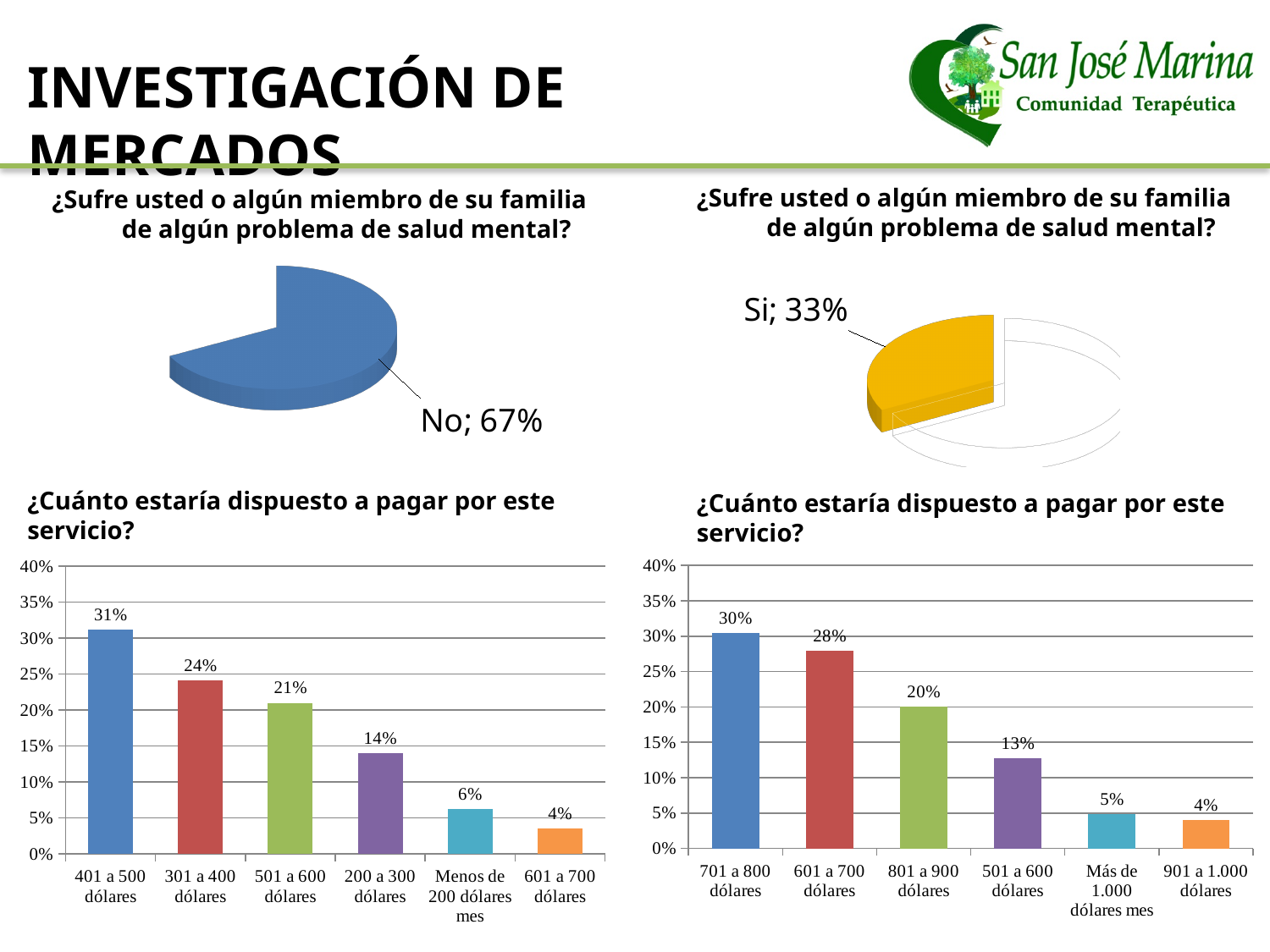
In the top-left pie chart, what share is labelled for No? 67% In the bottom-right bar chart, do the values rise or fall from left to right along the x axis? fall In the bottom-right bar chart, is the value for 701 a 800 dólares greater or less than 25%? greater In the bottom-left bar chart, what is the value for 401 a 500 dólares? 31% In the bottom-left bar chart, which category has the highest value? 401 a 500 dólares What kind of chart is the bottom-right chart on the slide? bar chart In the bottom-left bar chart, what is the difference between the values for 301 a 400 dólares and 200 a 300 dólares? 10% In the bottom-right bar chart, which category has the lowest value? 901 a 1.000 dólares In the bottom-right bar chart, which is larger: the value for 601 a 700 dólares or the value for 501 a 600 dólares? 601 a 700 dólares In the bottom-right bar chart, what is the value for 801 a 900 dólares? 20% In the top-right pie chart, what share is labelled for Si? 33% How many categories are shown in the bottom-left bar chart? 6